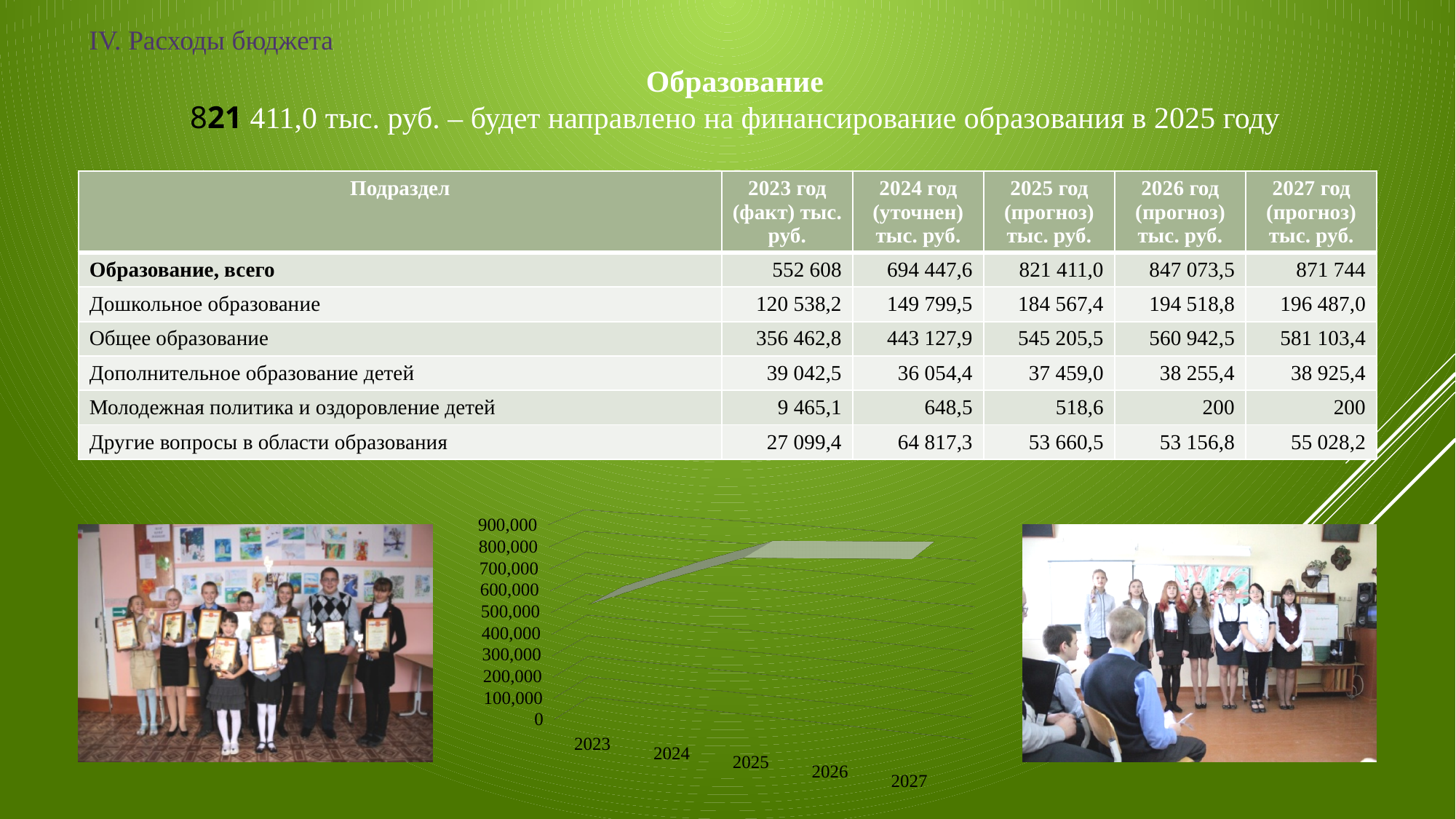
Is the value for 2027 in the chart greater or less than 700,000? greater What kind of chart is shown at the bottom centre of the slide? line chart How many years are plotted along the x axis of the chart? 5 Which is larger in the chart, the value for 2023 or the value for 2025? 2025 Which year has the lowest plotted value in the chart? 2023 Do the plotted values rise or fall from 2023 to 2027 in the chart? rise Is the value for 2024 in the chart greater or less than 600,000? greater What is the first year shown on the x axis of the chart? 2023 What is the highest tick label on the vertical axis of the chart? 900,000